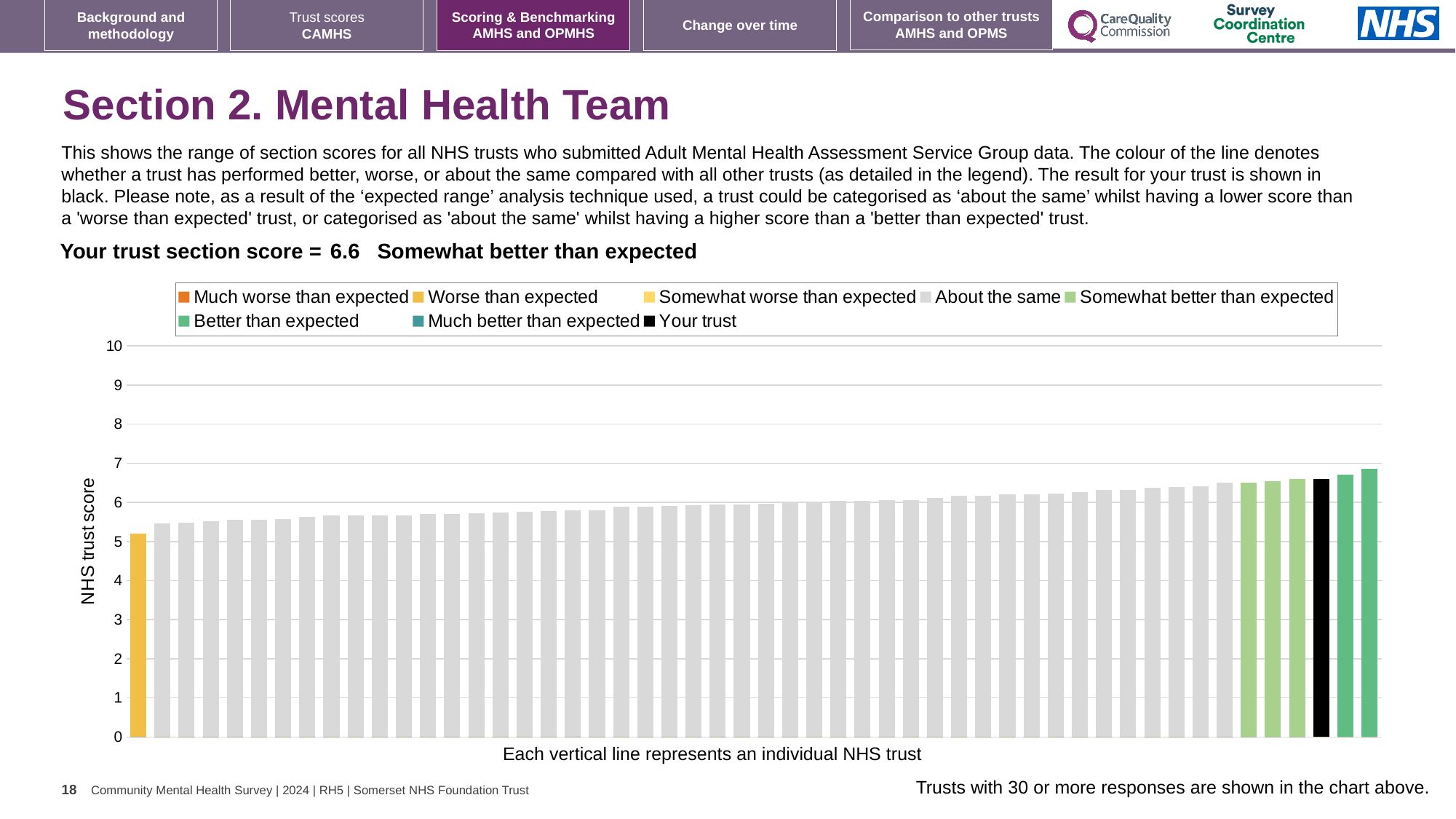
Is the value of the highest bar in the chart greater or less than 7? less How many entries does the chart legend list? 8 What is the label on the vertical axis of the chart? NHS trust score According to the caption below the chart, what does each vertical line represent? an individual NHS trust What kind of chart is shown on the slide? bar chart Which legend category does the lowest bar in the chart belong to? Worse than expected Is the value of the lowest bar in the chart greater or less than 6? less How many bars in the chart are coloured black? 1 Is the value of the black 'Your trust' bar greater or less than 6? greater Is the 'Your trust' bar higher or lower than the tallest bar in the chart? lower Which legend category does the highest bar in the chart belong to? Better than expected What is the section score for Your trust shown on the slide? 6.6